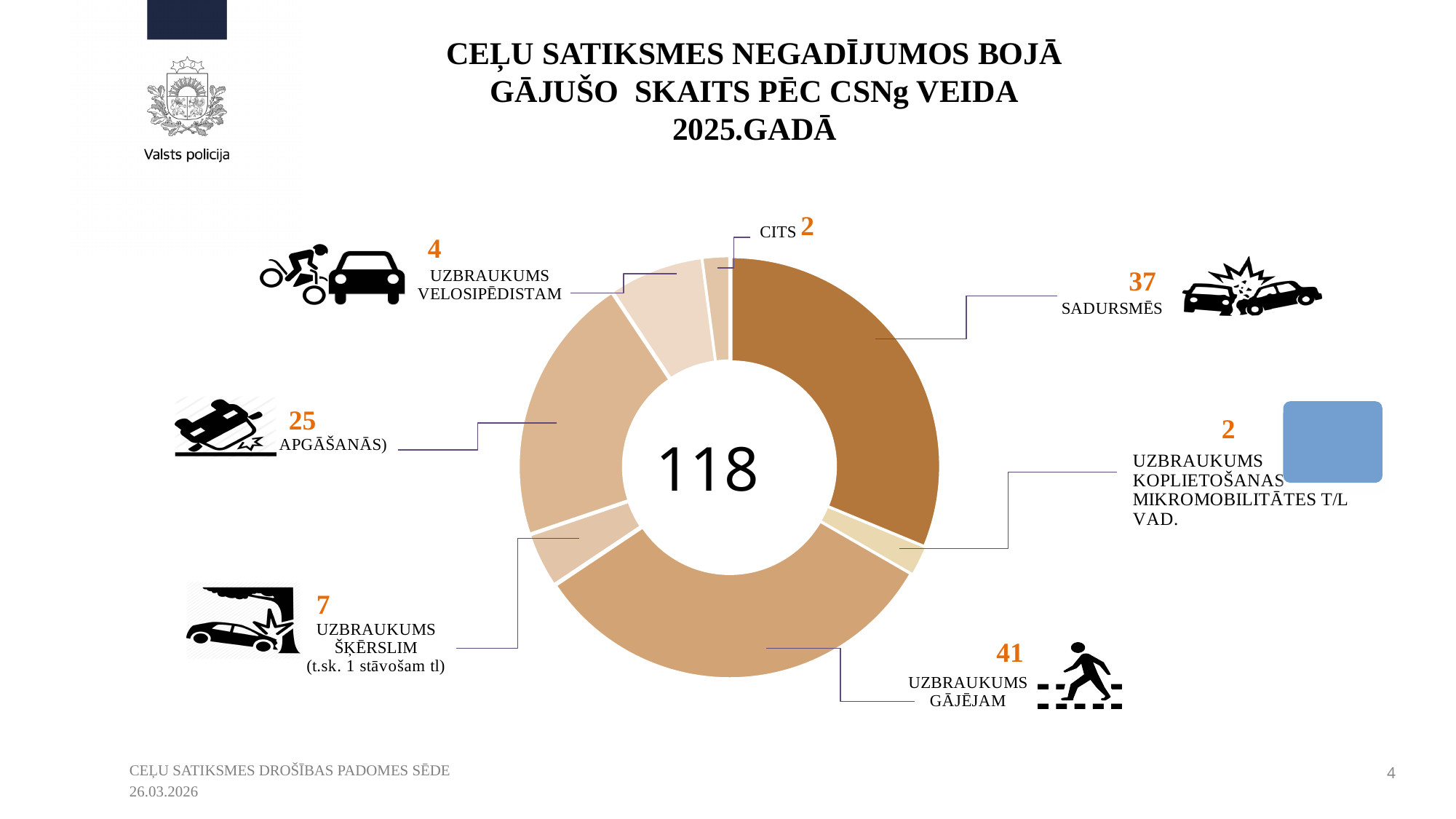
How many categories does the chart show? 7 What kind of chart is shown on the slide? Donut (pie) chart What is the value for UZBRAUKUMS VELOSIPĒDISTAM? 4 What is the value for APGĀŠANĀS? 25 What is the value for UZBRAUKUMS ŠĶĒRSLIM? 7 Which is larger, APGĀŠANĀS or UZBRAUKUMS ŠĶĒRSLIM? APGĀŠANĀS What is the difference between APGĀŠANĀS and UZBRAUKUMS VELOSIPĒDISTAM? 21 What is the difference between UZBRAUKUMS GĀJĒJAM and SADURSMĒS? 4 What is the value for UZBRAUKUMS GĀJĒJAM? 41 What total is shown in the centre of the chart? 118 What is the value for SADURSMĒS? 37 Which category has the highest value? UZBRAUKUMS GĀJĒJAM